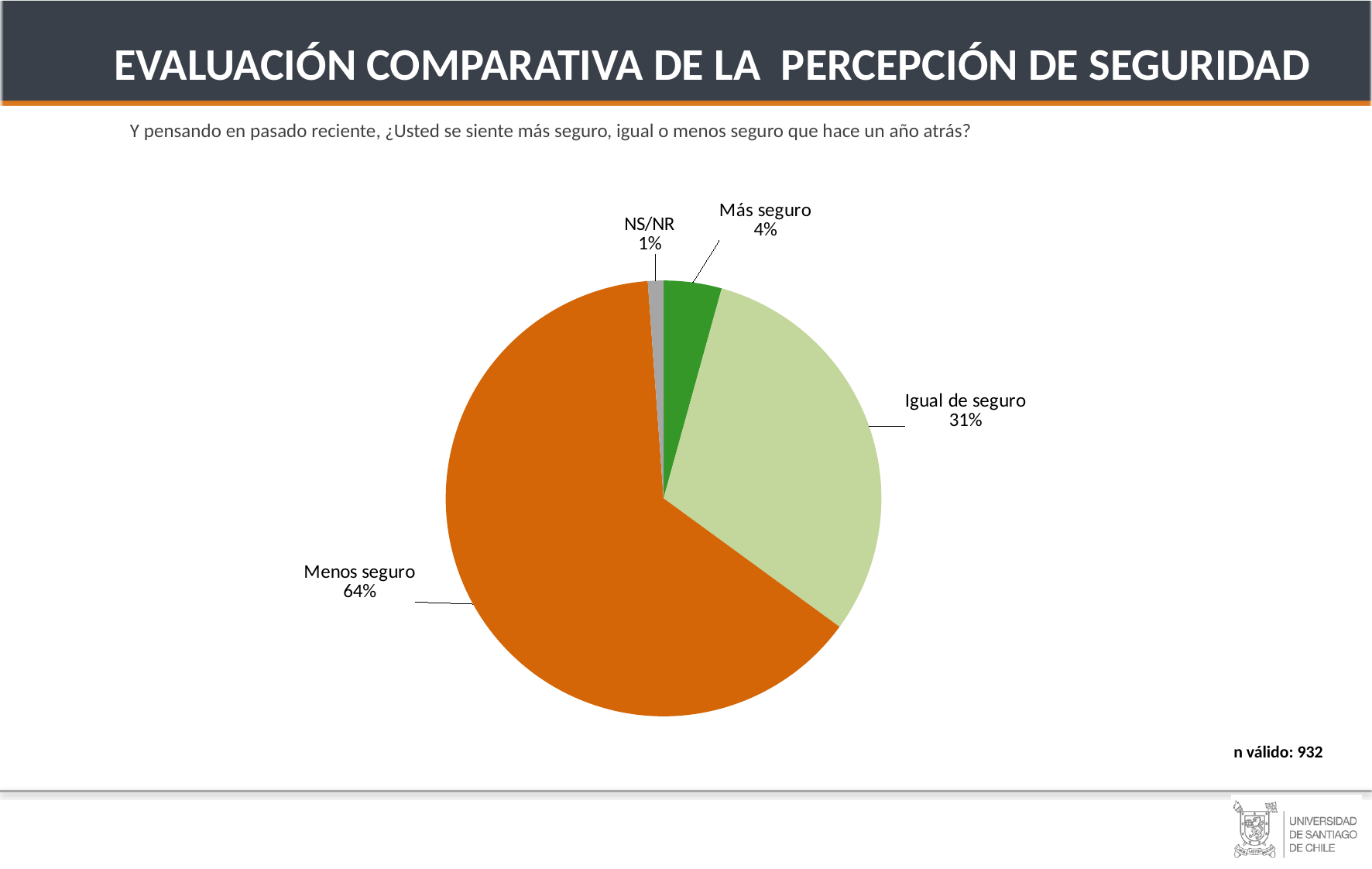
What percentage of respondents answered "Igual de seguro"? 31% What is the valid n reported on the slide? 932 What percentage of respondents answered "Menos seguro"? 64% What kind of chart is shown on the slide? pie chart Which is larger, the share for "Más seguro" or the share for "Igual de seguro"? Igual de seguro Which category has the largest share of the pie? Menos seguro What colour is the "Menos seguro" slice? orange What is the difference in percentage points between "Menos seguro" and "Igual de seguro"? 33 What percentage is shown for "NS/NR"? 1% How many slices does the pie chart have? 4 What percentage of respondents answered "Más seguro"? 4% Which category has the smallest share of the pie? NS/NR